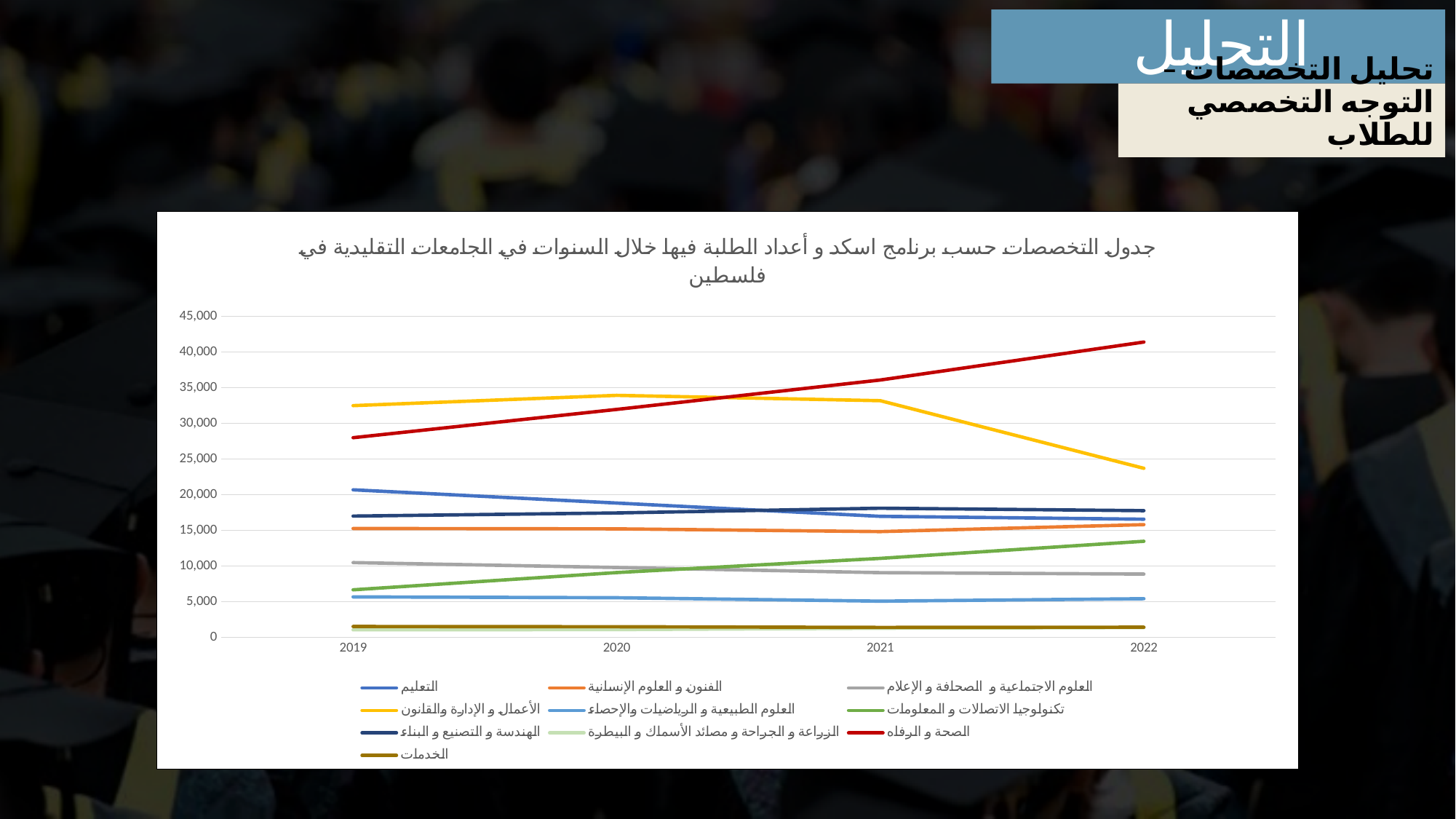
Is the value for الأعمال و الإدارة والقانون in 2019 greater or less than 30,000? greater Is the value for تكنولوجيا الاتصالات و المعلومات in 2022 greater or less than 10,000? greater How many series does the chart's legend list? 10 How many years are plotted along the x axis of the chart? 4 Is the value for الصحة و الرفاه in 2022 greater or less than 40,000? greater What colour is the line for الصحة و الرفاه in the chart? red In 2022, which is larger: the value for الصحة و الرفاه or the value for الأعمال و الإدارة والقانون? الصحة و الرفاه Does the value for الصحة و الرفاه rise or fall from 2019 to 2022? rise Does the value for الأعمال و الإدارة والقانون rise or fall from 2021 to 2022? fall Which series has the highest value in 2022? الصحة و الرفاه Which series has the highest value in 2019? الأعمال و الإدارة والقانون What kind of chart is shown on the slide? line chart